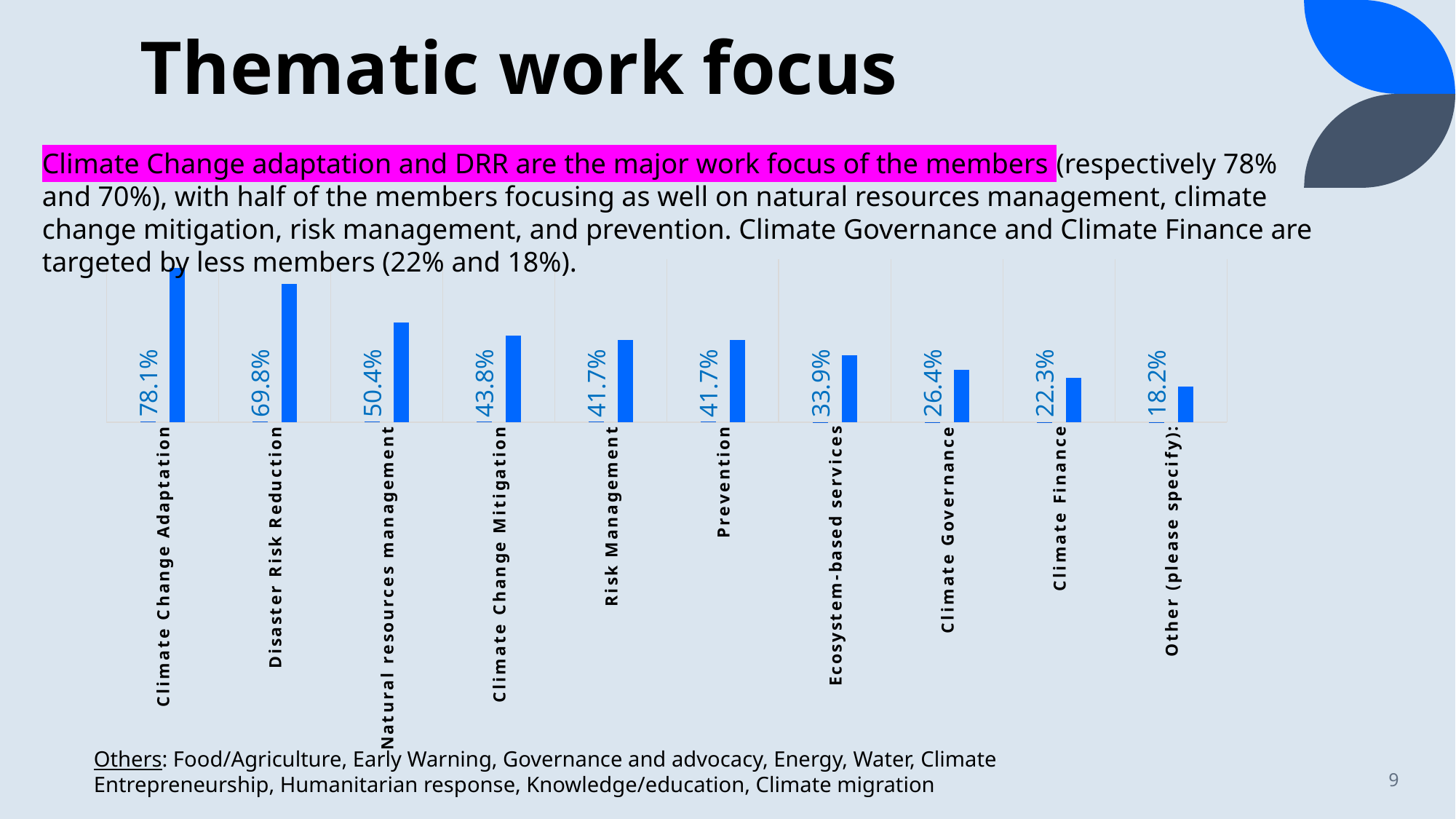
Do the values rise or fall from left to right across the categories? Fall Which category has the highest value? Climate Change Adaptation What is the value for Natural resources management? 50.4% What kind of chart is shown on the slide? Bar chart Which category has the lowest value? Other (please specify): What is the difference between Climate Change Adaptation and Disaster Risk Reduction? 8.3% What is the value for Ecosystem-based services? 33.9% What is the value for Climate Finance? 22.3% How many categories are shown in the chart? 10 What is the value for Climate Change Adaptation? 78.1% What is the value for Disaster Risk Reduction? 69.8% Which is larger, Climate Change Mitigation or Climate Governance? Climate Change Mitigation